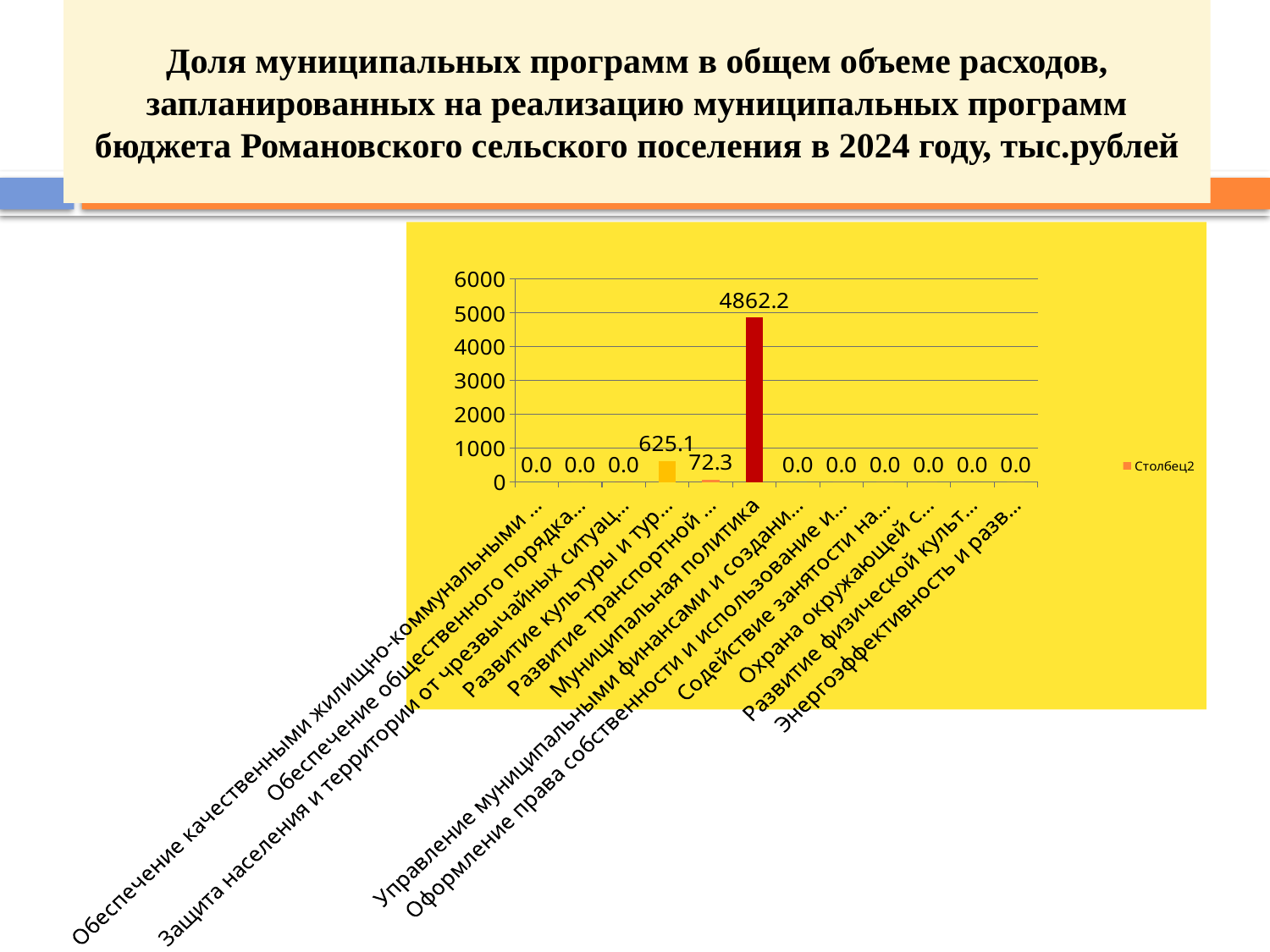
Which category has the highest value? Муниципальная политика How many series does the legend list? 1 What is the value for the category Развитие культуры и тур...? 625.1 What is the difference between the values for Развитие культуры и тур... and Развитие транспортной ...? 552.8 Is the value for Муниципальная политика greater or less than 4000? greater How many categories have a value of 0.0? 9 What is the difference between the values for Муниципальная политика and Развитие культуры и тур...? 4237.1 What is the value for Муниципальная политика? 4862.2 How many categories are shown on the x axis? 12 What kind of chart is shown on the slide? bar chart What is the value for the category Развитие транспортной ...? 72.3 Which is larger, the value for Развитие культуры и тур... or the value for Развитие транспортной ...? Развитие культуры и тур...